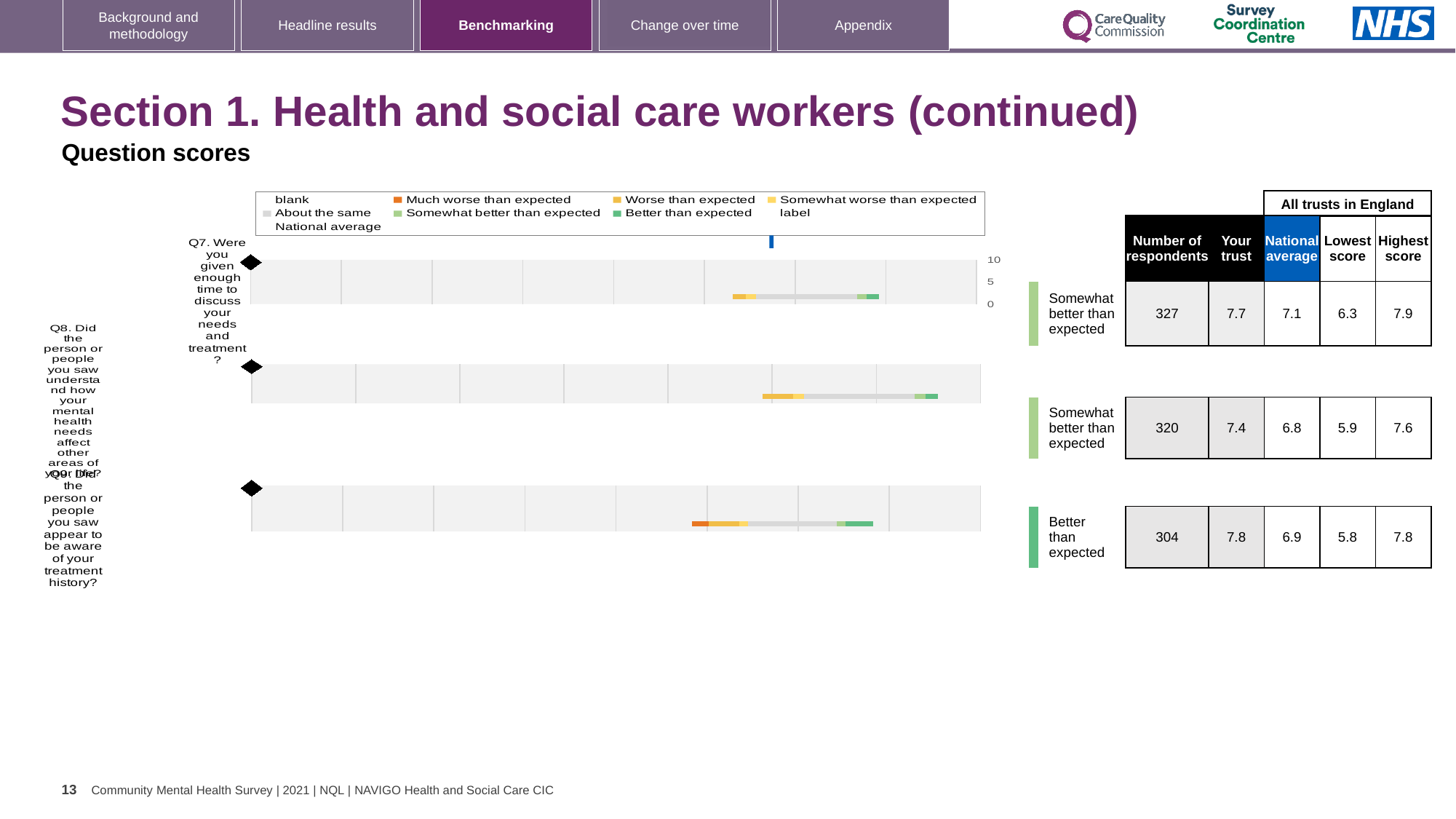
Which benchmark category is shown for Q9? Better than expected What is the national average score for Q7? 7.1 How many questions are charted on this slide? 3 What is the difference between the 'Your trust' score and the national average for Q7? 0.6 Which question has the highest 'Your trust' score? Q9 What kind of chart is used to show the question scores? Bar chart Which question has the lowest national average score? Q8 What is the 'Your trust' score for Q7 (Were you given enough time to discuss your needs and treatment?)? 7.7 Which is larger, the 'Your trust' score for Q7 or for Q8? Q7 What is the highest score across all trusts in England for Q9 (Did the person or people you saw appear to be aware of your treatment history?)? 7.8 What is the lowest score across all trusts in England for Q8? 5.9 How many respondents answered Q8 (Did the person or people you saw understand how your mental health needs affect other areas of your life?)? 320